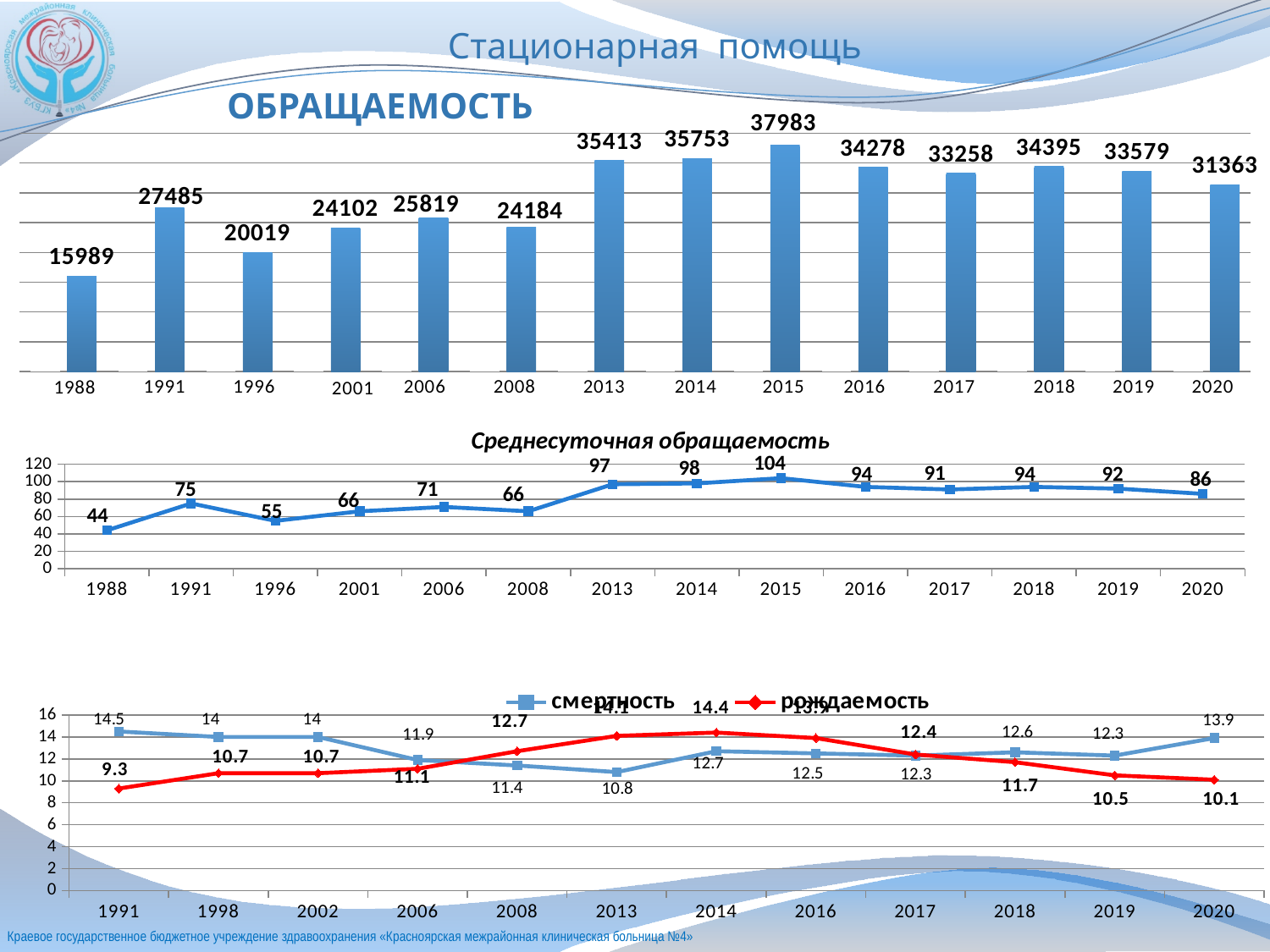
In the top bar chart (ОБРАЩАЕМОСТЬ), which is larger, the value for 1991 or the value for 1996? 1991 In the top bar chart (ОБРАЩАЕМОСТЬ), which year has the lowest value? 1988 In the bottom chart, which is larger in 1991, смертность or рождаемость? смертность In the middle chart (Среднесуточная обращаемость), what is the difference between the values for 1991 and 1988? 31 In the middle chart (Среднесуточная обращаемость), what is the value for 2013? 97 In the bottom chart, what is the value of рождаемость for 2020? 10.1 In the top bar chart (ОБРАЩАЕМОСТЬ), what is the value for 2015? 37983 How many series does the legend of the bottom chart list? 2 In the top bar chart (ОБРАЩАЕМОСТЬ), how many years are shown on the x axis? 14 In the middle chart (Среднесуточная обращаемость), which year has the highest value? 2015 What kind of chart is the top chart (ОБРАЩАЕМОСТЬ)? bar chart In the top bar chart (ОБРАЩАЕМОСТЬ), what is the difference between the values for 2015 and 2020? 6620